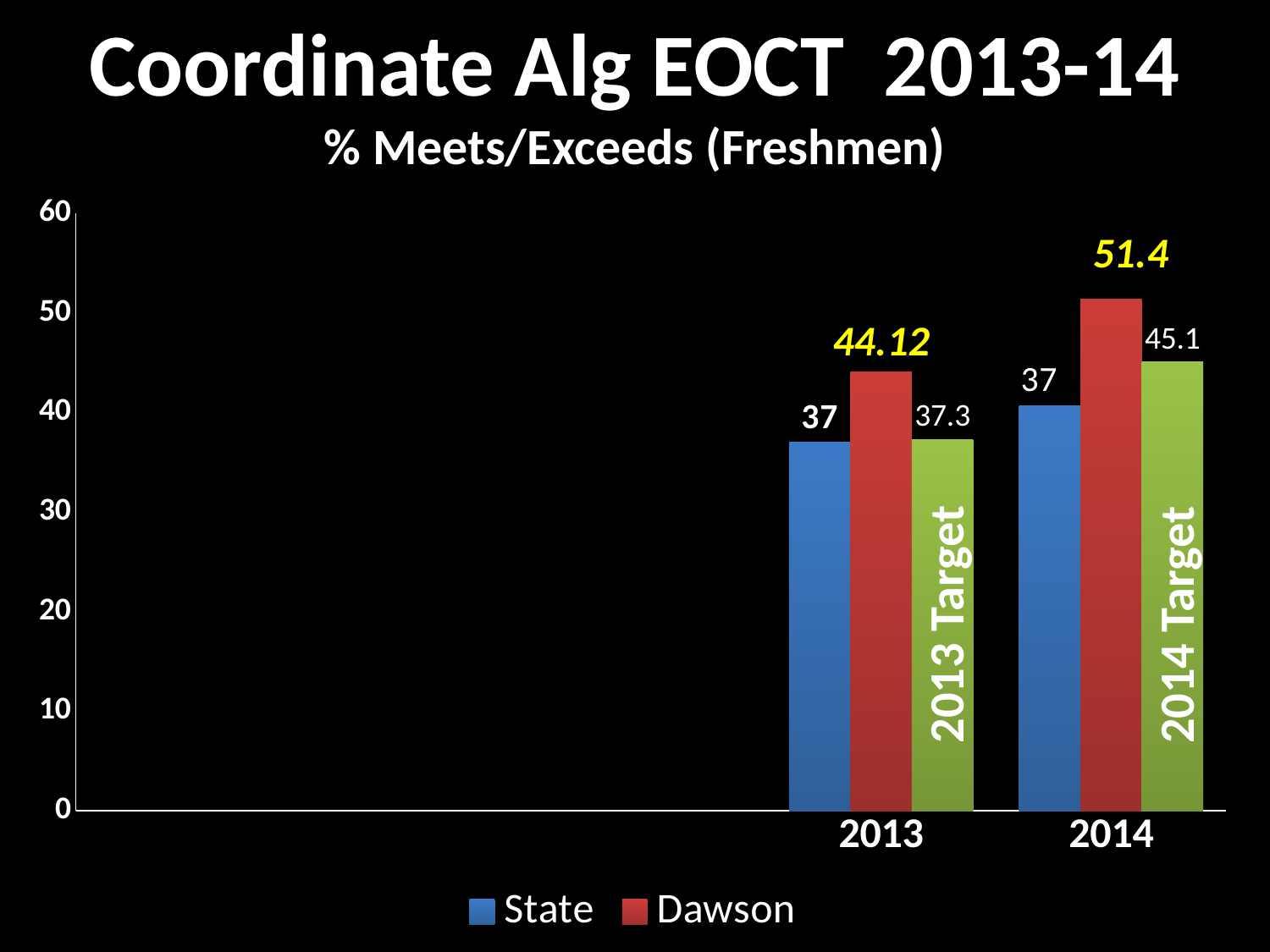
What is the Dawson value for 2014? 51.4 What kind of chart is shown on the slide? bar chart What is the Dawson value for 2013? 44.12 What is the State value for 2013? 37 What is the difference between the Dawson value for 2014 and the Dawson value for 2013? 7.28 Which bar has the highest value on the chart? Dawson 2014 What is the difference between the Dawson value for 2014 and the 2014 Target? 6.3 Does the Dawson value rise or fall from 2013 to 2014? rise What is the 2014 Target value? 45.1 What is the 2013 Target value? 37.3 How many series does the legend list? 2 Which is larger in 2013, the Dawson value or the State value? Dawson